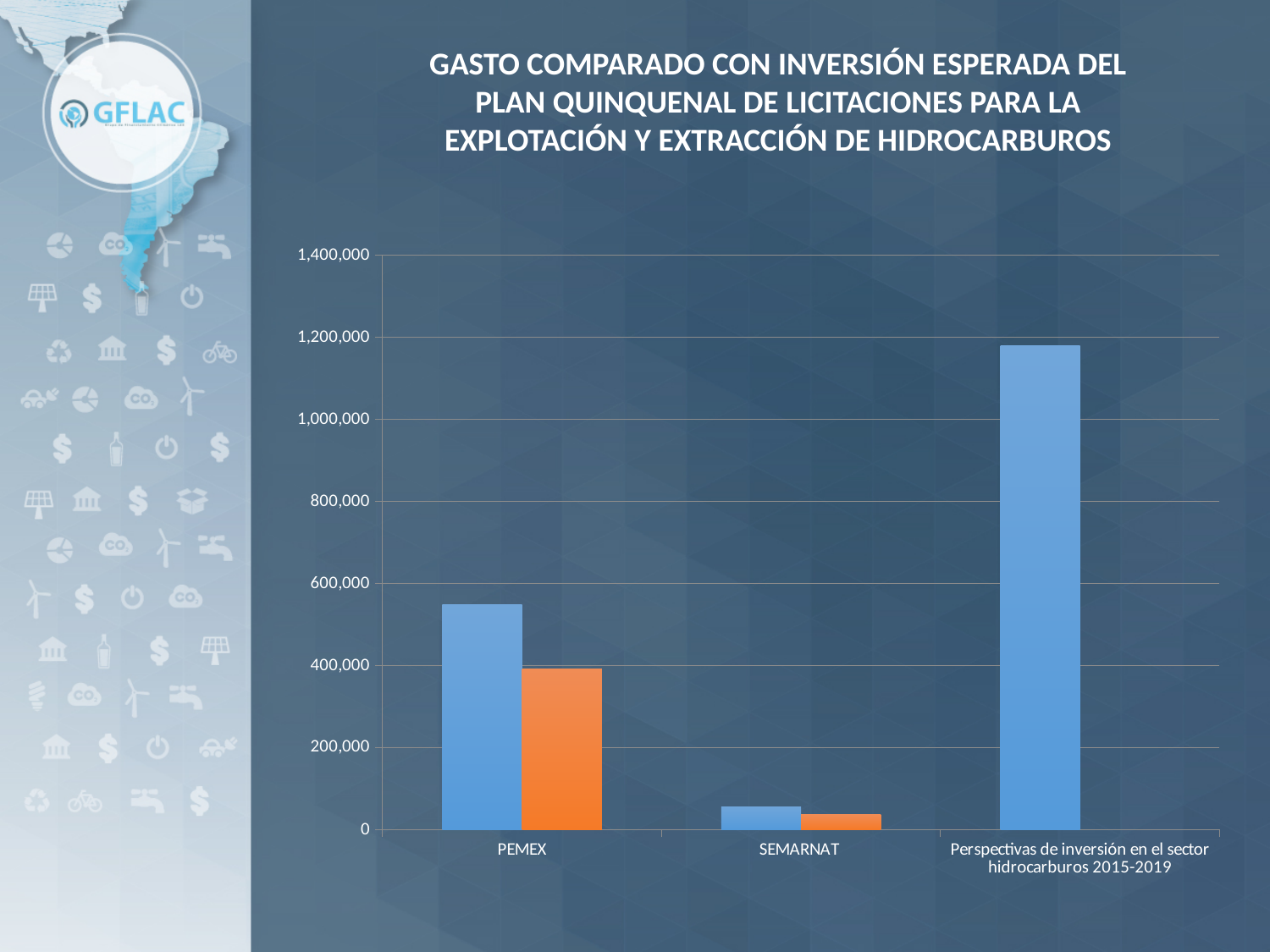
Is the value of the blue bar for SEMARNAT greater or less than 200,000? less Is the value of the bar for Perspectivas de inversión en el sector hidrocarburos 2015-2019 greater or less than 1,000,000? greater Which category has the tallest bar in the chart? Perspectivas de inversión en el sector hidrocarburos 2015-2019 What is the highest value shown on the vertical axis of the chart? 1,400,000 How many categories are shown on the x axis of the chart? 3 Is the value of the blue bar for PEMEX greater or less than 400,000? greater For PEMEX, which bar is taller, the blue one or the orange one? the blue one Which category has the shortest bars in the chart? SEMARNAT Which is larger, the blue bar for PEMEX or the blue bar for SEMARNAT? PEMEX What kind of chart is shown on the slide? bar chart